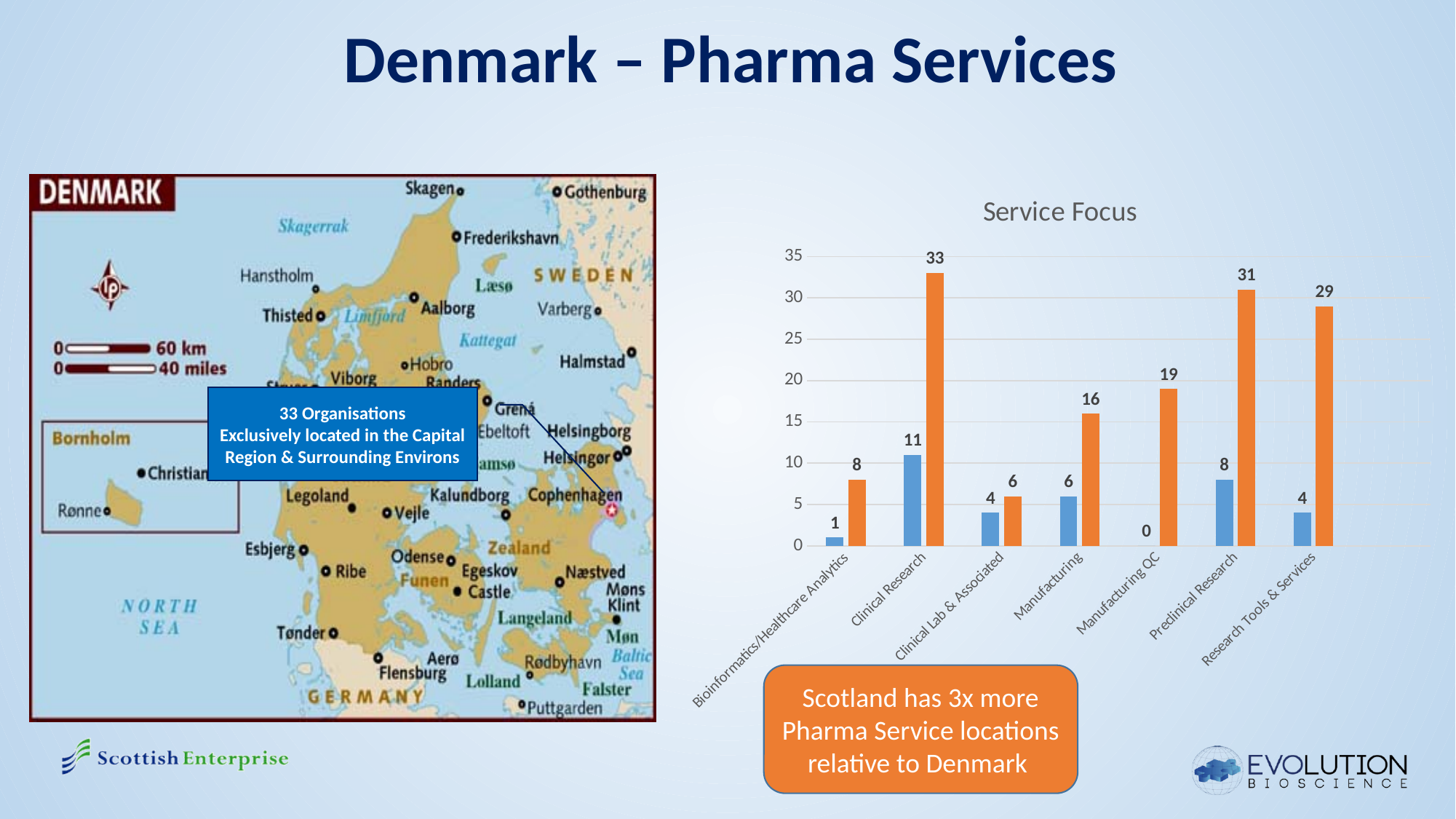
In the Service Focus chart, what is the difference between the orange and blue bars for Research Tools & Services? 25 In the Service Focus chart, what is the value of the blue bar for Preclinical Research? 8 What is the title of the chart on the slide? Service Focus In the Service Focus chart, which category has the lowest blue bar? Manufacturing QC In the Service Focus chart, what is the value of the orange bar for Bioinformatics/Healthcare Analytics? 8 In the Service Focus chart, what is the difference between the orange and blue bars for Clinical Research? 22 How many categories are shown on the x axis of the Service Focus chart? 7 In the Service Focus chart, what is the value of the blue bar for Manufacturing QC? 0 In the Service Focus chart, which category has the highest orange bar? Clinical Research In the Service Focus chart, which is larger: the orange bar for Manufacturing or the orange bar for Clinical Lab & Associated? Manufacturing What kind of chart is the Service Focus chart? bar chart In the Service Focus chart, what is the value of the orange bar for Clinical Research? 33